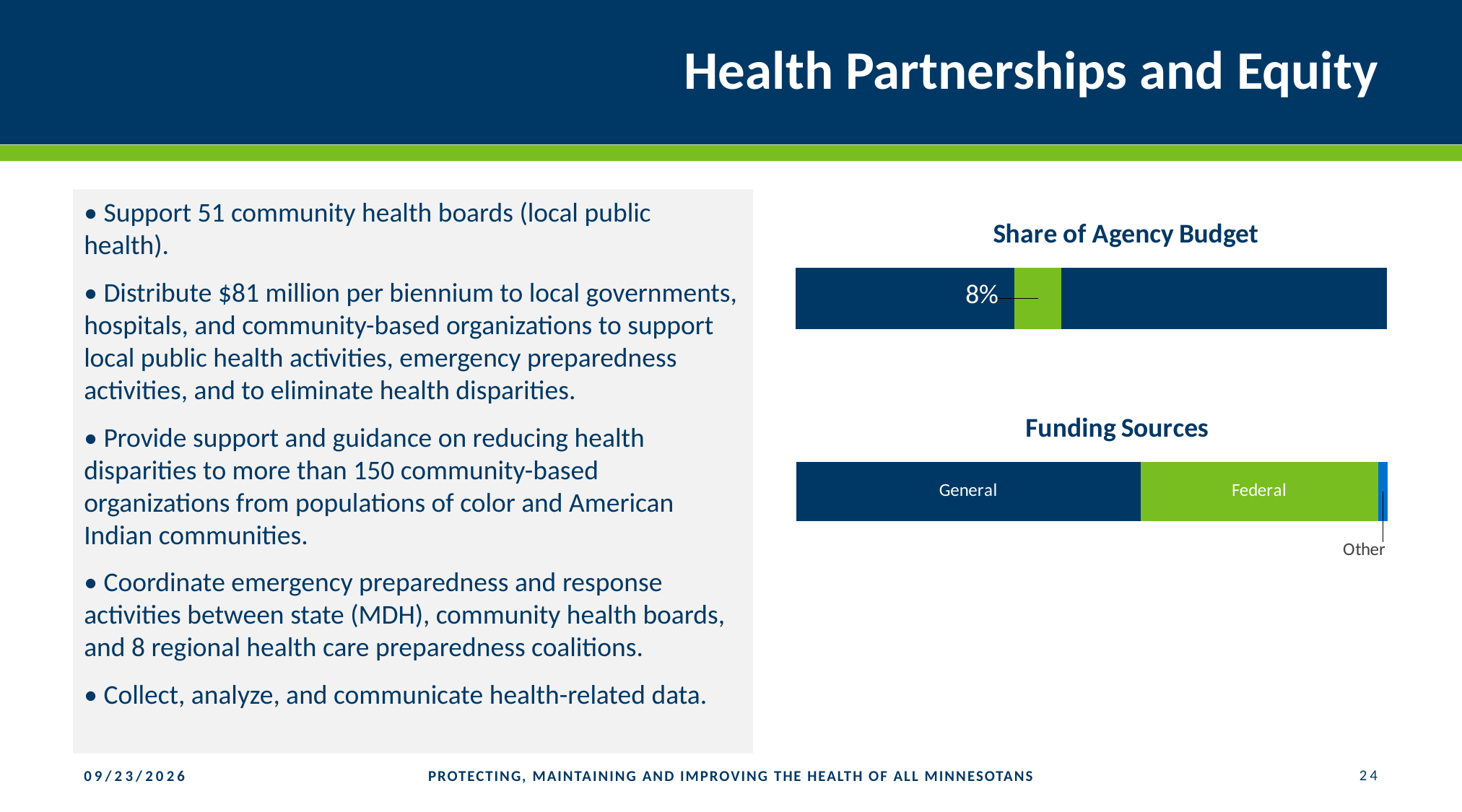
In the Funding Sources chart, what colour is the Federal segment? green In the Funding Sources chart, which funding source has the largest share? General How many charts are shown on the slide? 2 In the Funding Sources chart, which funding source has the smallest share? Other What kind of chart is the Funding Sources chart? bar chart In the Share of Agency Budget chart, what percentage is labeled on the highlighted green segment? 8% In the Funding Sources chart, which is larger, Federal or Other? Federal In the Funding Sources chart, how many funding source segments are shown? 3 What kind of chart is the Share of Agency Budget chart? bar chart In the Funding Sources chart, which is larger, General or Federal? General In the Funding Sources chart, what are the three funding sources labeled? General, Federal, Other